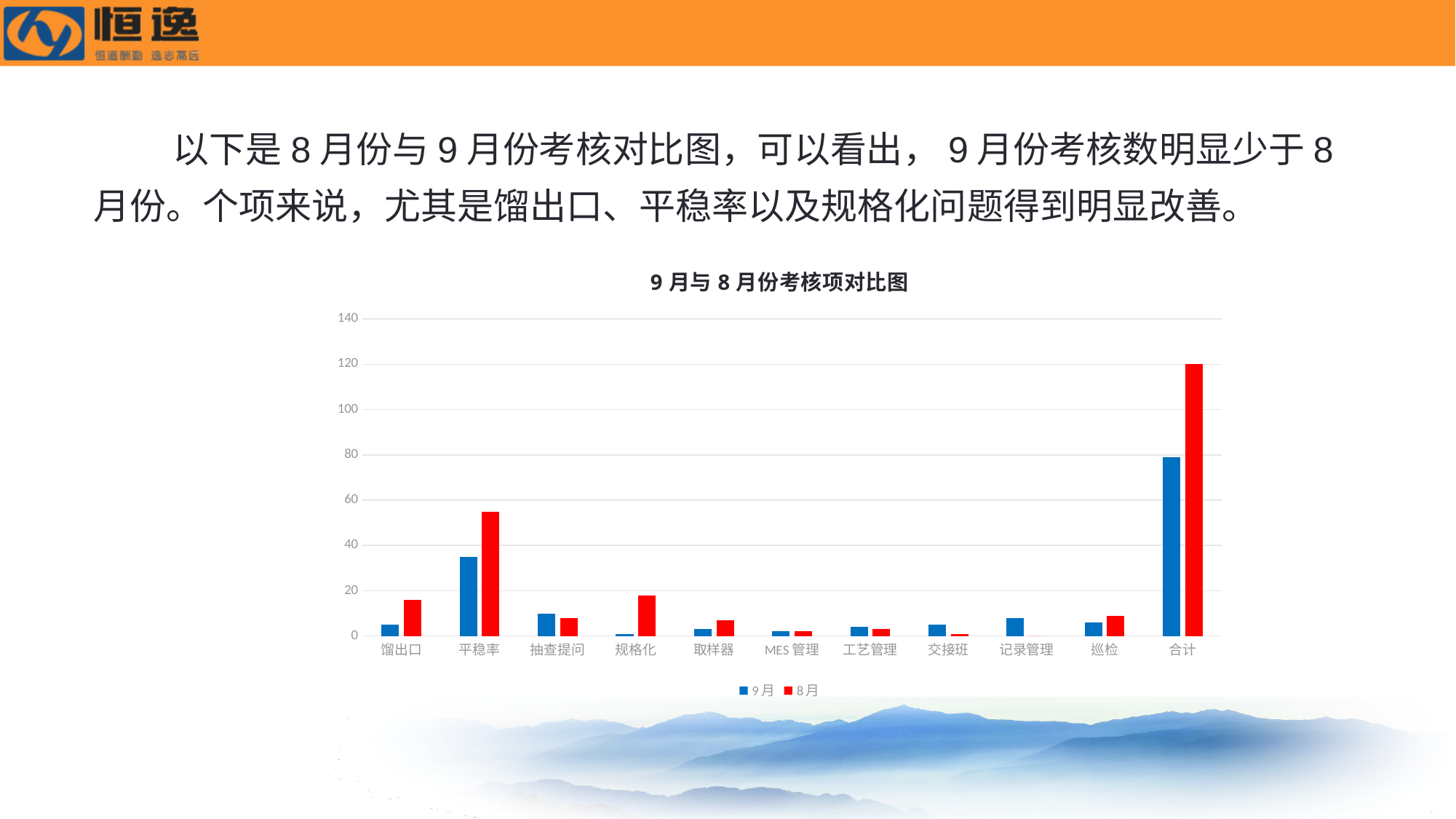
Which category has the highest value for the 9月 series? 合计 How many categories are shown on the x axis? 11 What kind of chart is shown on the slide? bar chart Which colour represents the 8月 series? red Is the 9月 value for 合计 greater or less than 60? greater How many series does the legend list? 2 What is the 8月 value for 合计? 120 Which category has the highest value for the 8月 series? 合计 For 记录管理, which series has the larger value, 9月 or 8月? 9月 What is the title of the chart? 9月与8月份考核项对比图 Is the 8月 value for 平稳率 greater or less than 40? greater For 馏出口, which series has the larger value, 9月 or 8月? 8月